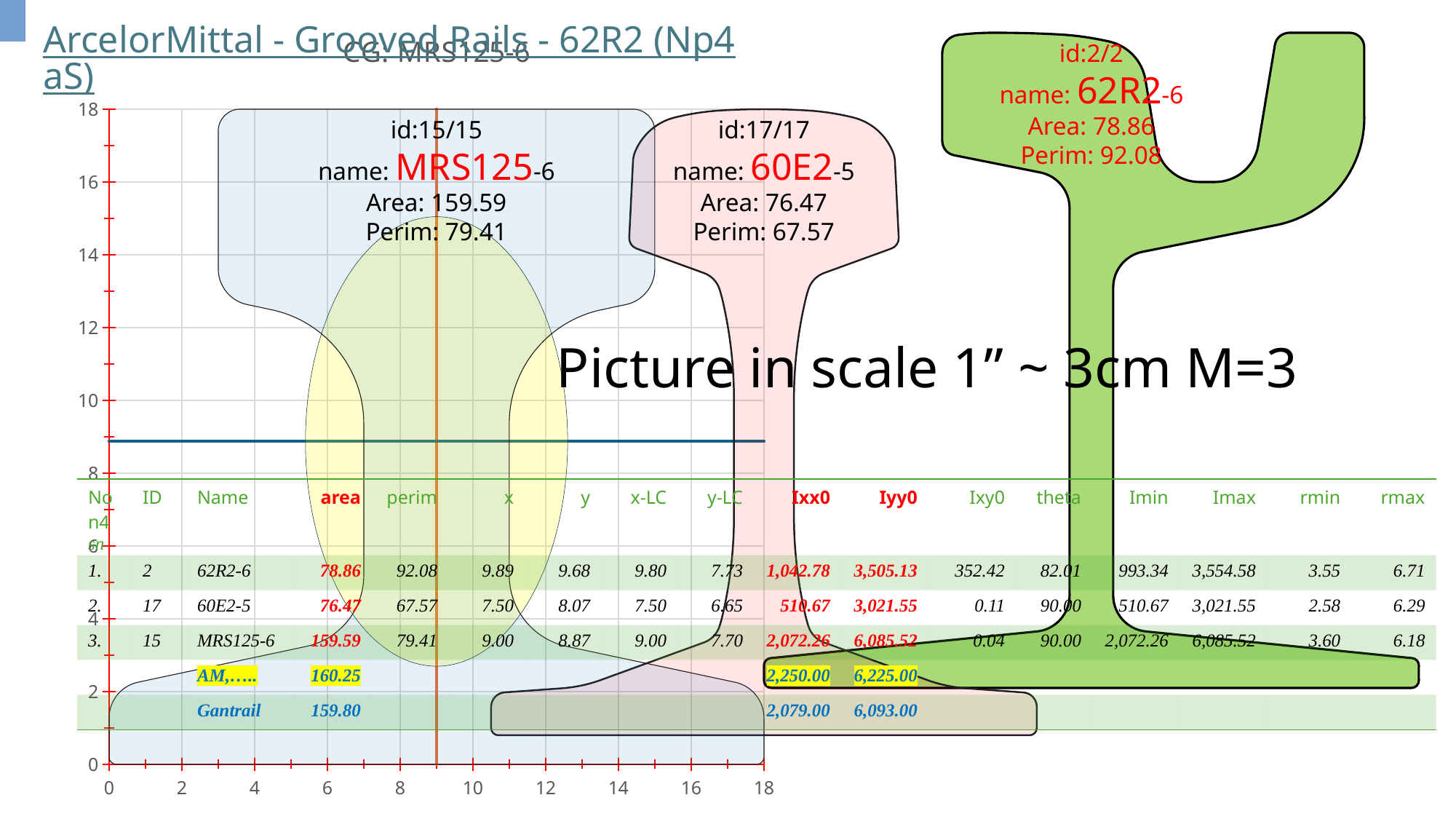
What Perim value is printed for the 62R2-6 profile? 92.08 How many rail profile shapes are drawn on the grid? 3 What is the difference between the printed Area of MRS125-6 and that of 60E2-5? 83.12 What Area value is printed for the 60E2-5 profile? 76.47 What Area value is printed for the 62R2-6 profile? 78.86 Which profile has the larger printed Perim, 62R2-6 or MRS125-6? 62R2-6 Which of the three rail profiles drawn on the grid has the largest printed Area? MRS125-6 What Perim value is printed for the MRS125-6 profile? 79.41 What is the highest tick value shown on the horizontal axis of the grid? 18 Which of the three rail profiles drawn on the grid has the smallest printed Area? 60E2-5 What Perim value is printed for the 60E2-5 profile? 67.57 What Area value is printed for the MRS125-6 profile? 159.59